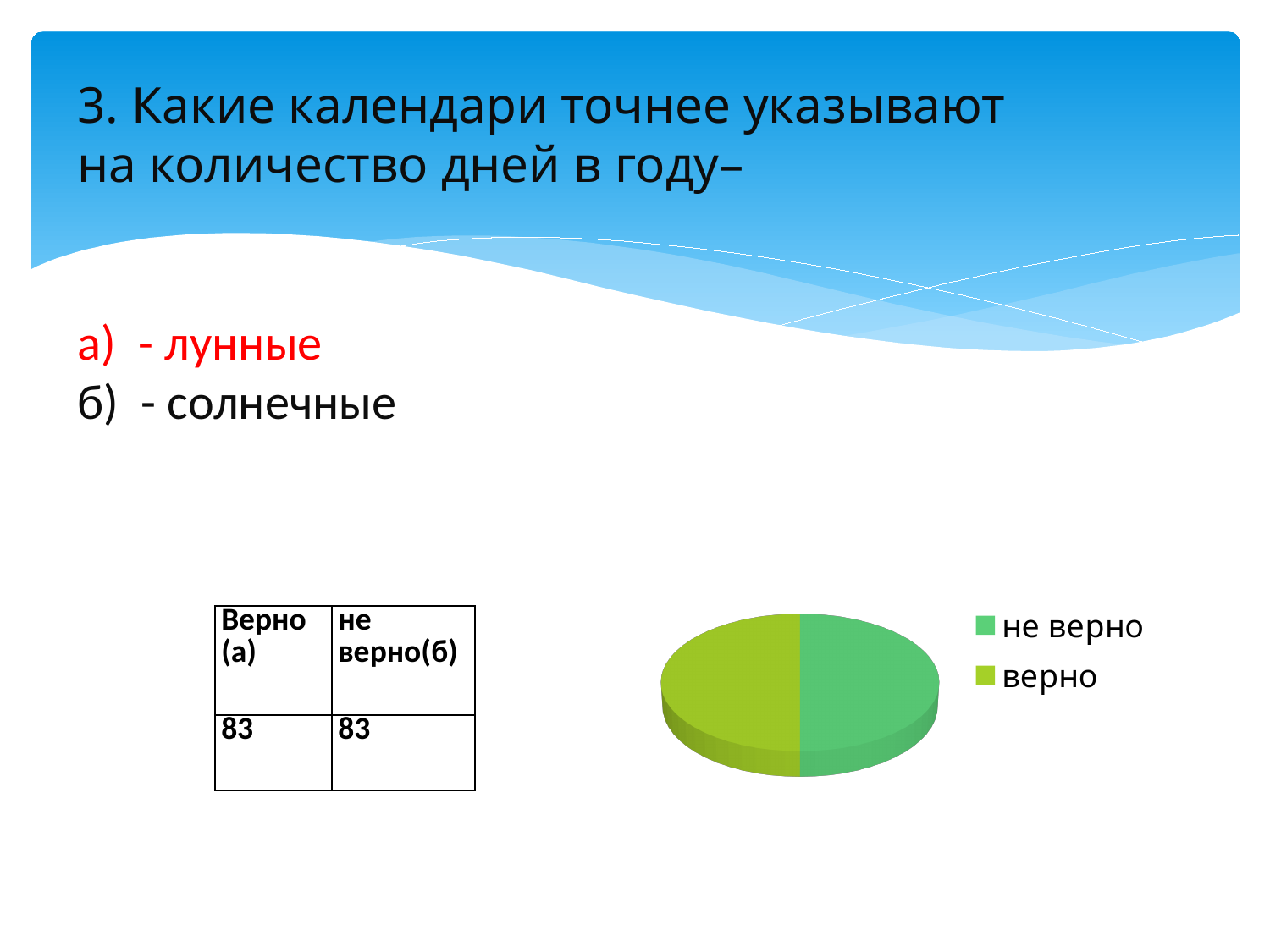
How many slices does the pie chart have? 2 What share of the pie does the "не верно" slice take? 50% According to the table next to the pie chart, what is the value for "Верно (а)"? 83 What are the two legend entries of the pie chart? не верно, верно According to the table next to the pie chart, what is the value for "не верно(б)"? 83 How many entries does the pie chart's legend list? 2 What share of the pie does the "верно" slice take? 50% What kind of chart is shown on the slide? pie chart Which legend entry is shown in yellow-green in the pie chart? верно